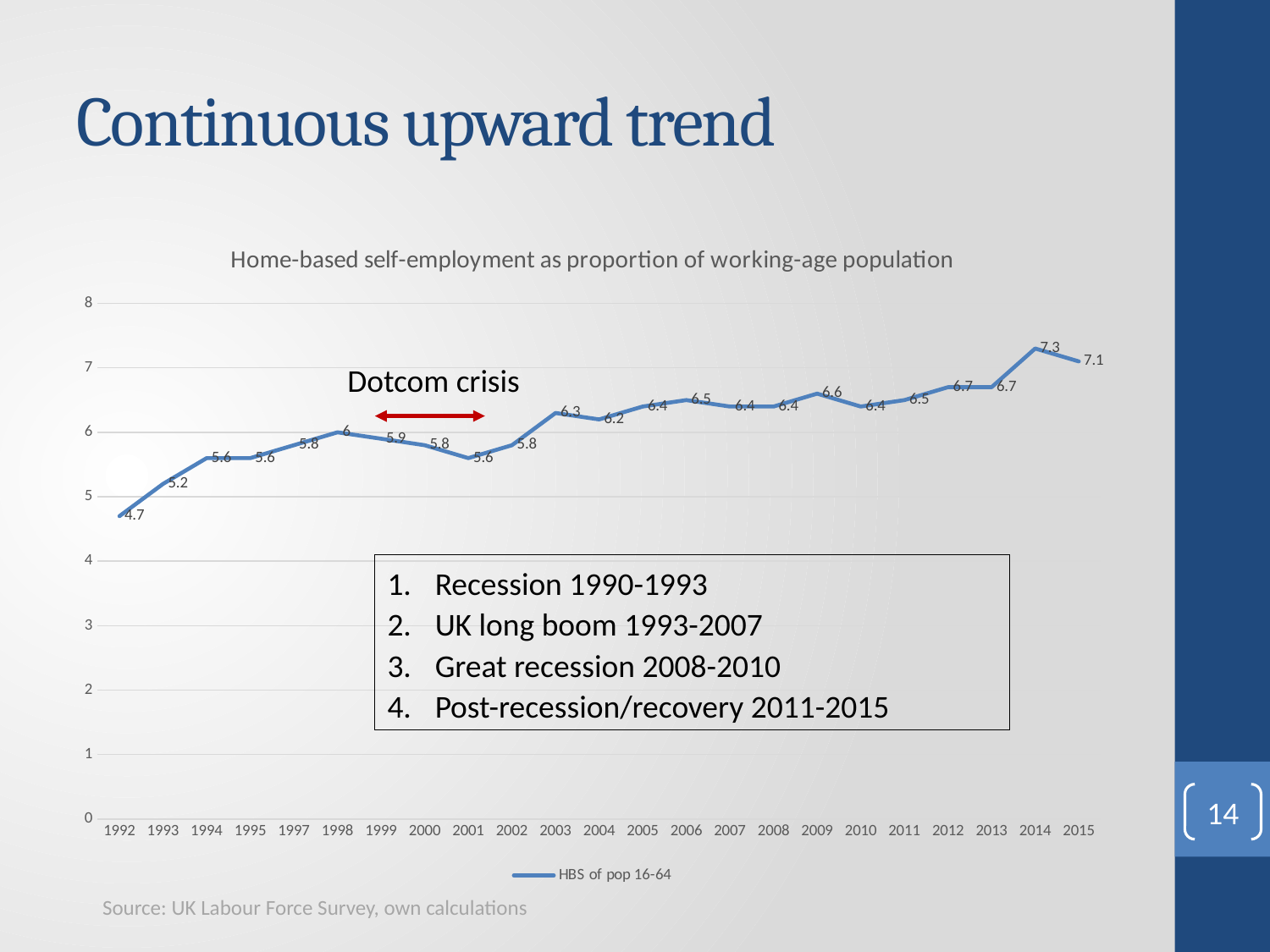
What is the value for 2001? 5.6 What is the title of the chart? Home-based self-employment as proportion of working-age population Do the values generally rise or fall from 1992 to 2015? rise How many series does the legend list? 1 What is the value for 2014? 7.3 Which year has the highest value? 2014 What is the difference between the values for 2015 and 1992? 2.4 What is the value for 1992? 4.7 What kind of chart is shown? line chart Which is larger, the value for 2003 or the value for 2004? 2003 Which year has the lowest value? 1992 How many years are plotted on the x axis? 23